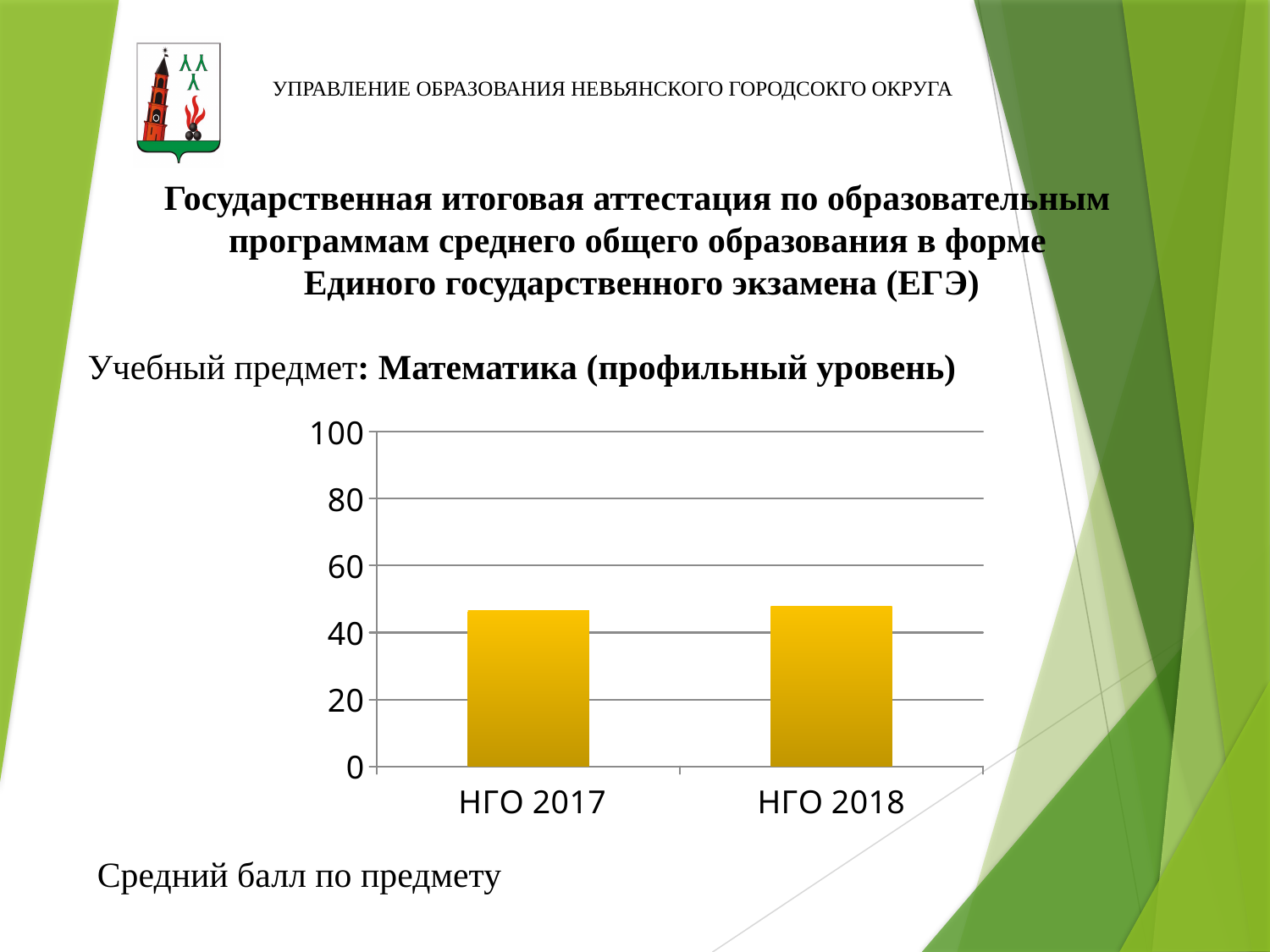
What are the two category labels on the x axis of the chart? НГО 2017, НГО 2018 What kind of chart is shown on the slide? bar chart How many bars (categories) does the chart show? 2 Is the value for НГО 2017 greater or less than 60? less Is the value for НГО 2018 greater or less than 80? less Is the value for НГО 2017 greater or less than 40? greater What is the highest value shown on the chart's vertical axis? 100